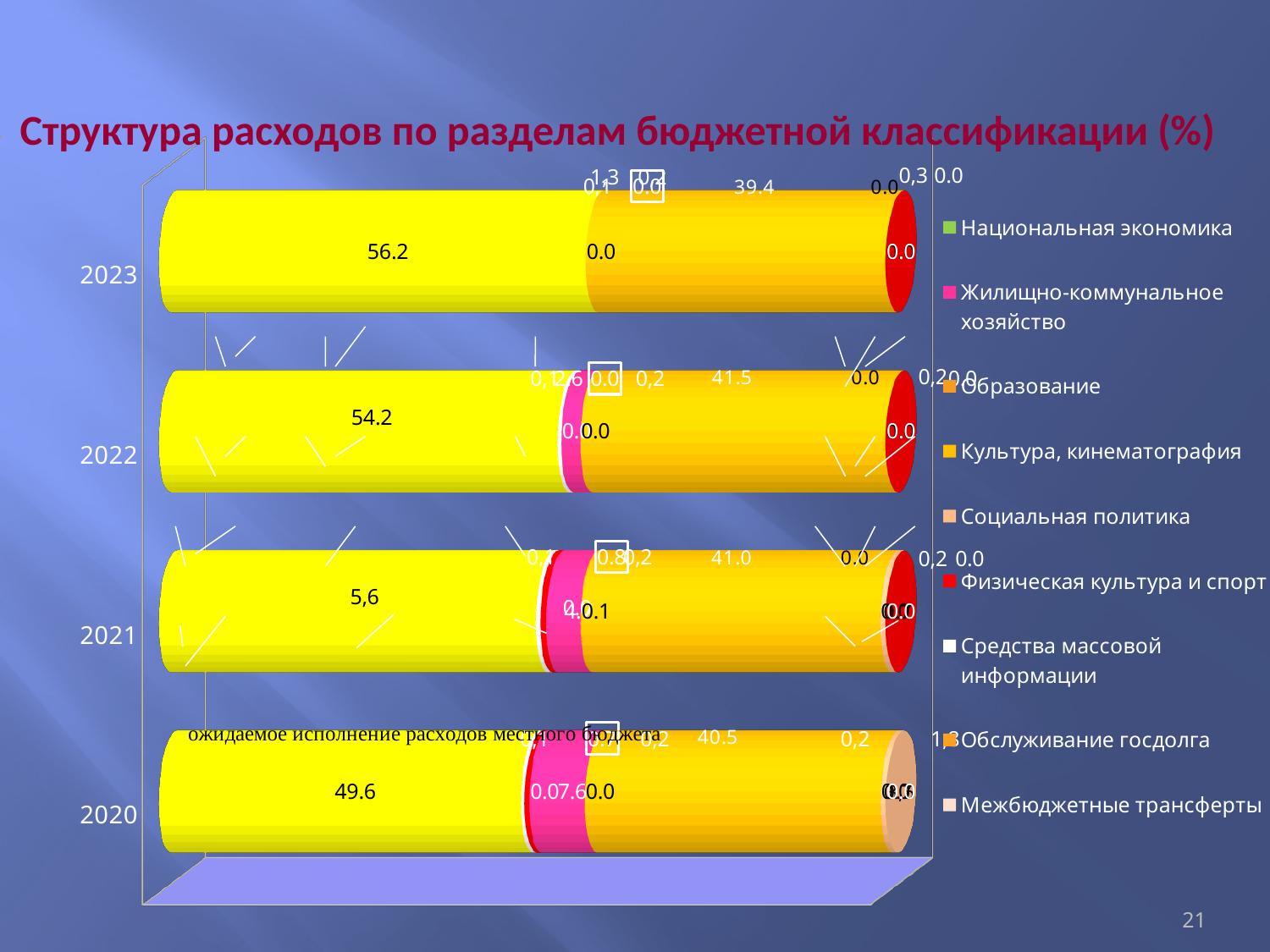
What is the value printed above the orange segment of the 2022 bar? 41.5 What is the title of the chart? Структура расходов по разделам бюджетной классификации (%) What is the value printed on the large yellow segment of the 2020 bar? 49.6 Which year has the longest yellow segment? 2023 What is the difference between the yellow segment values for 2023 (56.2) and 2022 (54.2)? 2.0 What is the value printed above the orange segment of the 2023 bar? 39.4 What is the value printed on the large yellow segment of the 2022 bar? 54.2 What is the value printed on the large yellow segment of the 2023 bar? 56.2 How many series does the chart legend list? 9 Which year has the shortest yellow segment? 2020 What kind of chart is shown on the slide? bar chart How many years (categories) are plotted on the chart? 4